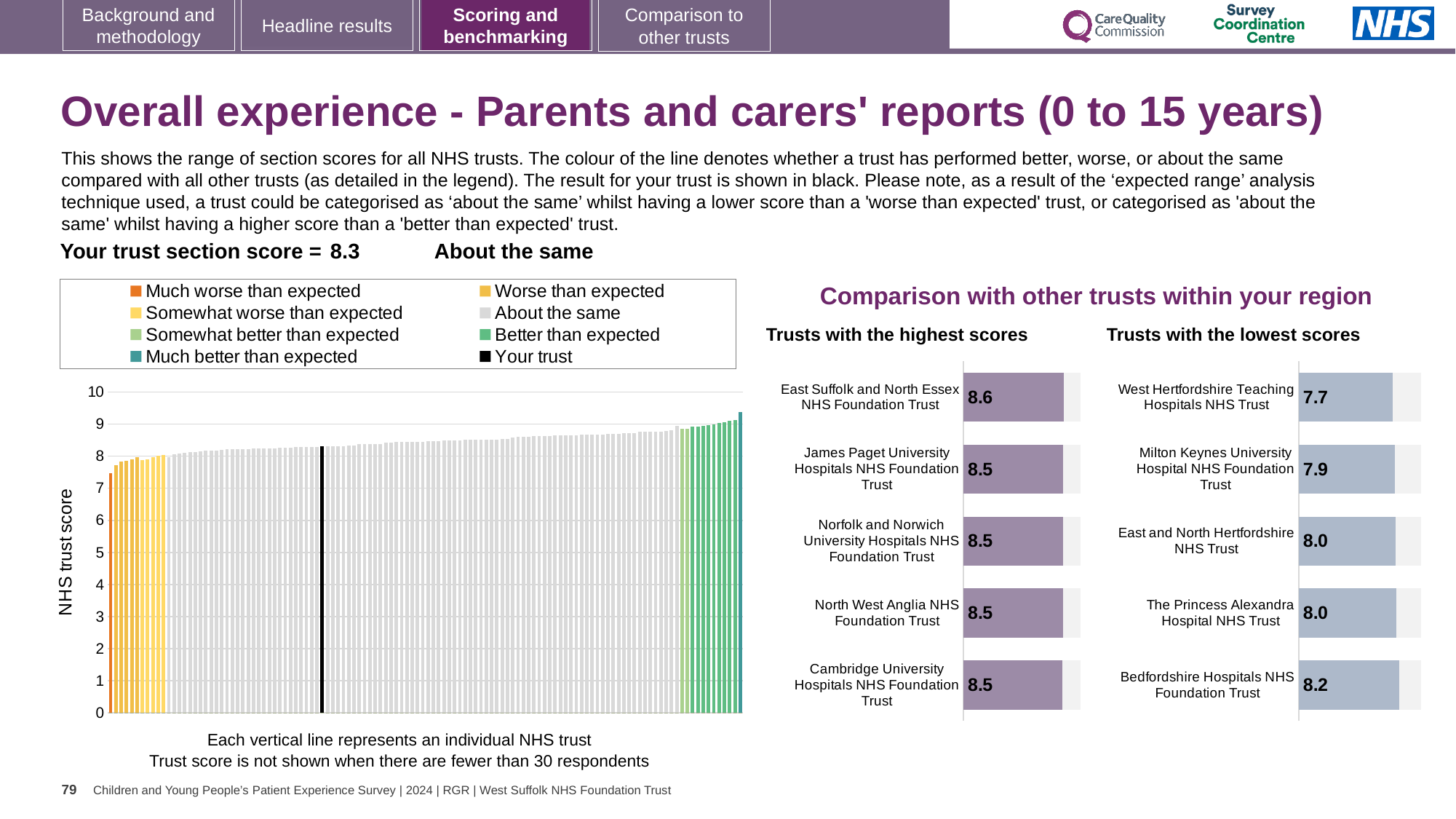
In the large chart on the left, do the trust scores rise or fall from left to right along the x axis? Rise In the 'Trusts with the lowest scores' chart, which trust has the lowest score? West Hertfordshire Teaching Hospitals NHS Trust How many entries does the legend above the large chart on the left list? 8 In the 'Trusts with the lowest scores' chart, what is the score for Milton Keynes University Hospital NHS Foundation Trust? 7.9 In the 'Trusts with the highest scores' chart, what is the difference between the scores of East Suffolk and North Essex NHS Foundation Trust and Cambridge University Hospitals NHS Foundation Trust? 0.1 How many trusts are shown in the 'Trusts with the lowest scores' chart? 5 What kind of chart is the large chart on the left showing NHS trust scores? Bar chart In the 'Trusts with the lowest scores' chart, which has the higher score: Milton Keynes University Hospital NHS Foundation Trust or Bedfordshire Hospitals NHS Foundation Trust? Bedfordshire Hospitals NHS Foundation Trust In the 'Trusts with the highest scores' chart, which trust has the highest score? East Suffolk and North Essex NHS Foundation Trust In the 'Trusts with the lowest scores' chart, what is the difference between the scores of Bedfordshire Hospitals NHS Foundation Trust and West Hertfordshire Teaching Hospitals NHS Trust? 0.5 What is the y-axis label of the large chart on the left? NHS trust score In the 'Trusts with the highest scores' chart, what is the score for East Suffolk and North Essex NHS Foundation Trust? 8.6